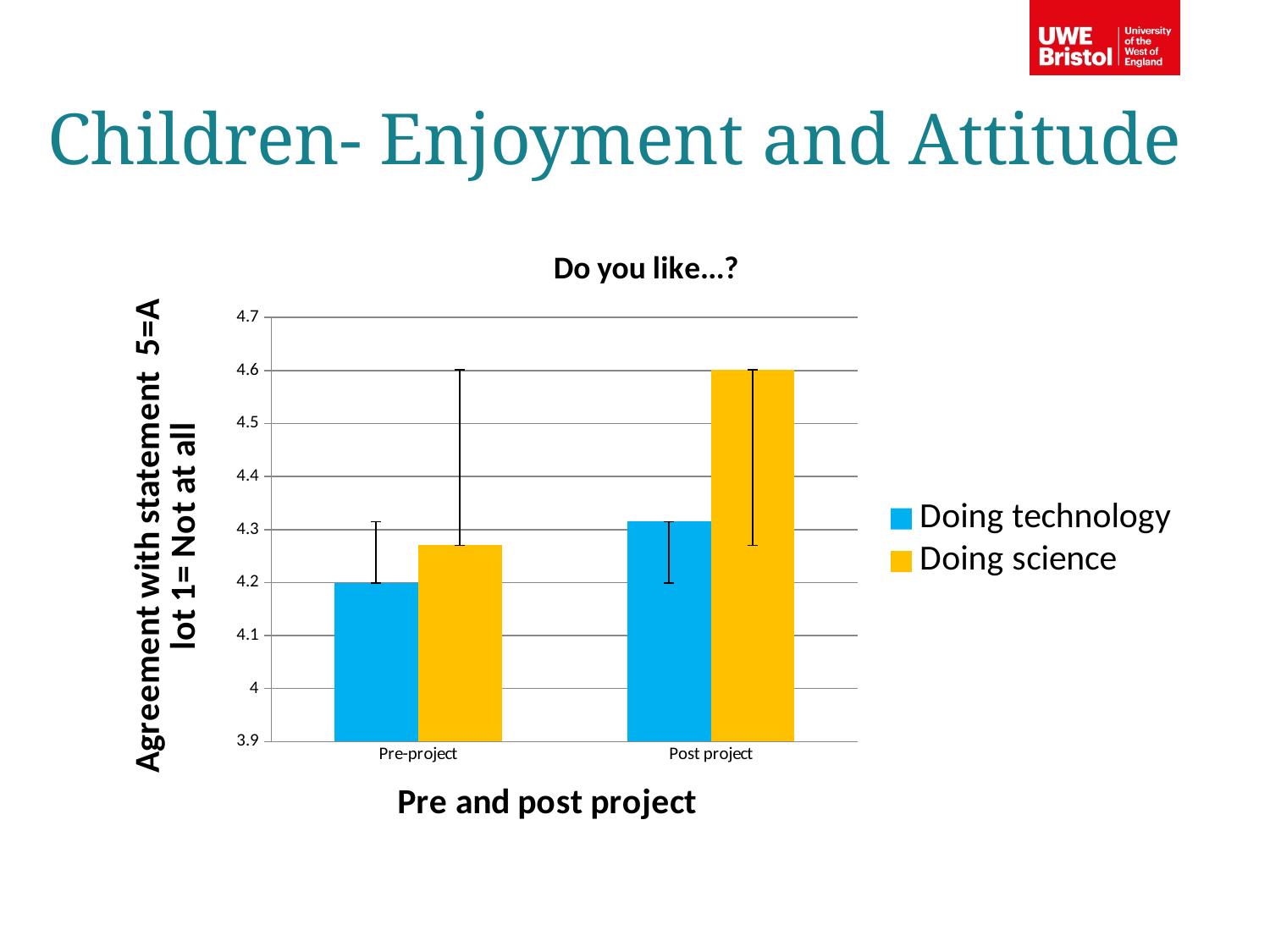
What is the value for Doing technology in the Pre-project category? 4.2 Is the value for Doing science in the Pre-project category greater or less than 4.2? greater Which bar is the highest in the chart? Doing science, Post project How many categories are shown on the x axis? 2 Which bar is the lowest in the chart? Doing technology, Pre-project Is the value for Doing technology in the Post project category greater or less than 4.4? less In the Post project category, which is larger: Doing technology or Doing science? Doing science Does the value for Doing science rise or fall from Pre-project to Post project? rise How many series does the legend list? 2 What is the value for Doing science in the Post project category? 4.6 What is the title of the chart? Do you like...? What type of chart is shown on the slide? Bar chart